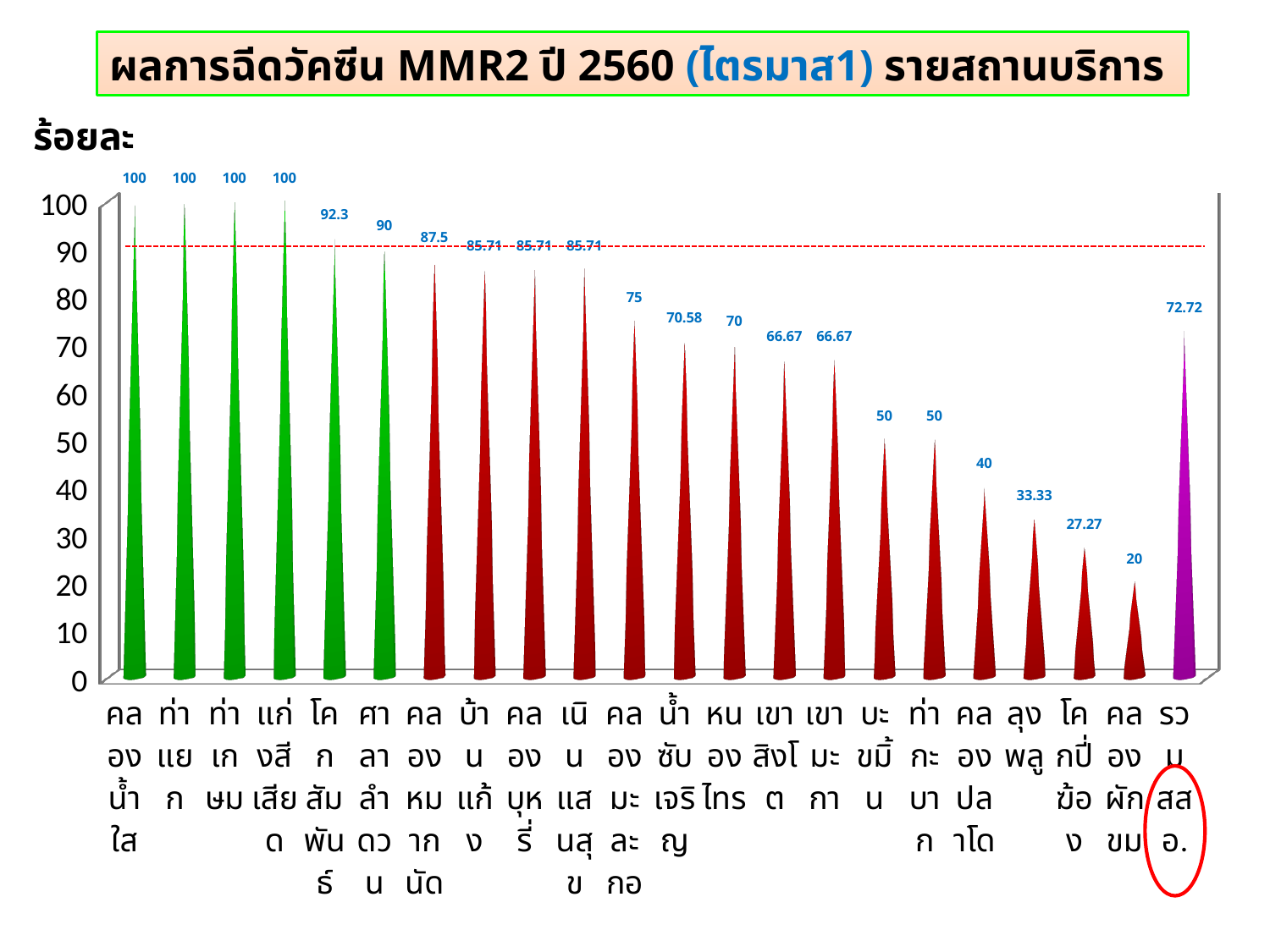
At what value is the red dashed horizontal line drawn? 90 What is the difference between the values for รวม สสอ. and คลองผักขม? 52.72 What is the value for น้ำซับเจริญ? 70.58 What is the value for คลองน้ำใส? 100 Is the value for คลองปลาโด greater or less than 50? less Which category has the lowest value? คลองผักขม How many categories are shown on the x axis? 22 What kind of chart is this? bar chart What is the value for รวม สสอ.? 72.72 What is the value for ลุงพลู? 33.33 What is the value for โคกสัมพันธ์? 92.3 Which is larger, the value for ศาลาลำดวน or the value for คลองหมากนัด? ศาลาลำดวน